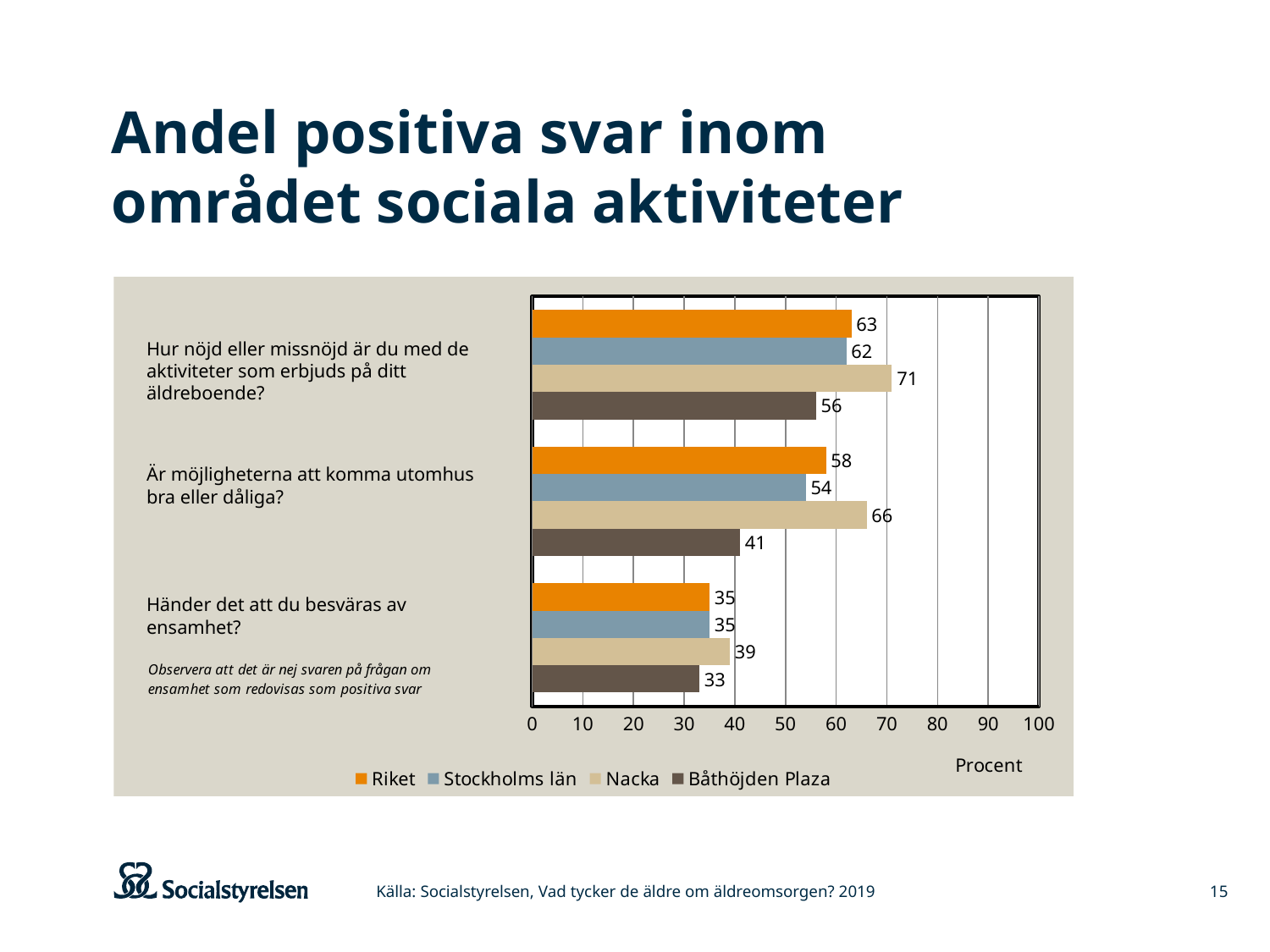
How many questions (categories) are shown on the chart? 3 What kind of chart is shown on the slide? Bar chart What is the difference between Stockholms län and Båthöjden Plaza on the question "Händer det att du besväras av ensamhet?"? 2 What is the value for Nacka on the question "Hur nöjd eller missnöjd är du med de aktiviteter som erbjuds på ditt äldreboende?"? 71 Which is larger on the question "Hur nöjd eller missnöjd är du med de aktiviteter som erbjuds på ditt äldreboende?": Riket or Stockholms län? Riket What is the label of the horizontal axis? Procent Which series has the lowest value on the question "Hur nöjd eller missnöjd är du med de aktiviteter som erbjuds på ditt äldreboende?"? Båthöjden Plaza Which series has the highest value on the question "Är möjligheterna att komma utomhus bra eller dåliga?"? Nacka What is the difference between Nacka and Båthöjden Plaza on the question "Är möjligheterna att komma utomhus bra eller dåliga?"? 25 What is the value for Riket on the question "Händer det att du besväras av ensamhet?"? 35 How many series does the legend list? 4 What is the value for Båthöjden Plaza on the question "Är möjligheterna att komma utomhus bra eller dåliga?"? 41